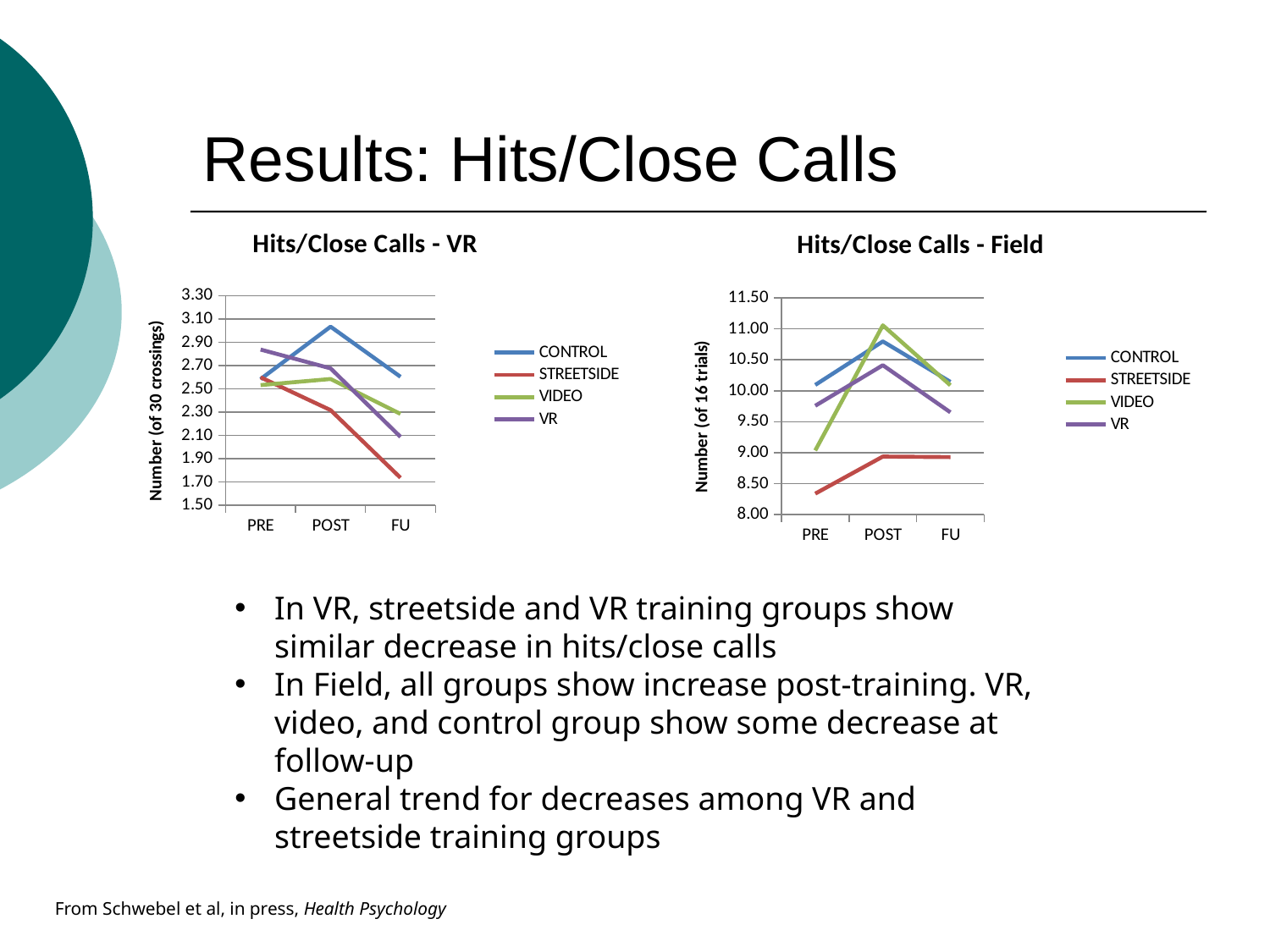
In the 'Hits/Close Calls - Field' chart, is the STREETSIDE value at PRE greater or less than 8.50? less In the 'Hits/Close Calls - VR' chart, which series has the lowest value at FU? STREETSIDE What is the y-axis title of the 'Hits/Close Calls - Field' chart? Number (of 16 trials) What kind of chart is the 'Hits/Close Calls - VR' chart? line chart In the 'Hits/Close Calls - VR' chart, which series has the highest value at POST? CONTROL In the 'Hits/Close Calls - VR' chart, at PRE, which is larger: the VR value or the CONTROL value? VR In the 'Hits/Close Calls - VR' chart, is the STREETSIDE value at FU greater or less than 1.90? less In the 'Hits/Close Calls - VR' chart, does the STREETSIDE line rise or fall from PRE to FU? fall How many series does the legend of the 'Hits/Close Calls - Field' chart list? 4 In the 'Hits/Close Calls - Field' chart, which series has the lowest value at PRE? STREETSIDE In the 'Hits/Close Calls - VR' chart, is the CONTROL value at POST greater or less than 2.90? greater How many categories are shown on the x axis of the 'Hits/Close Calls - VR' chart? 3